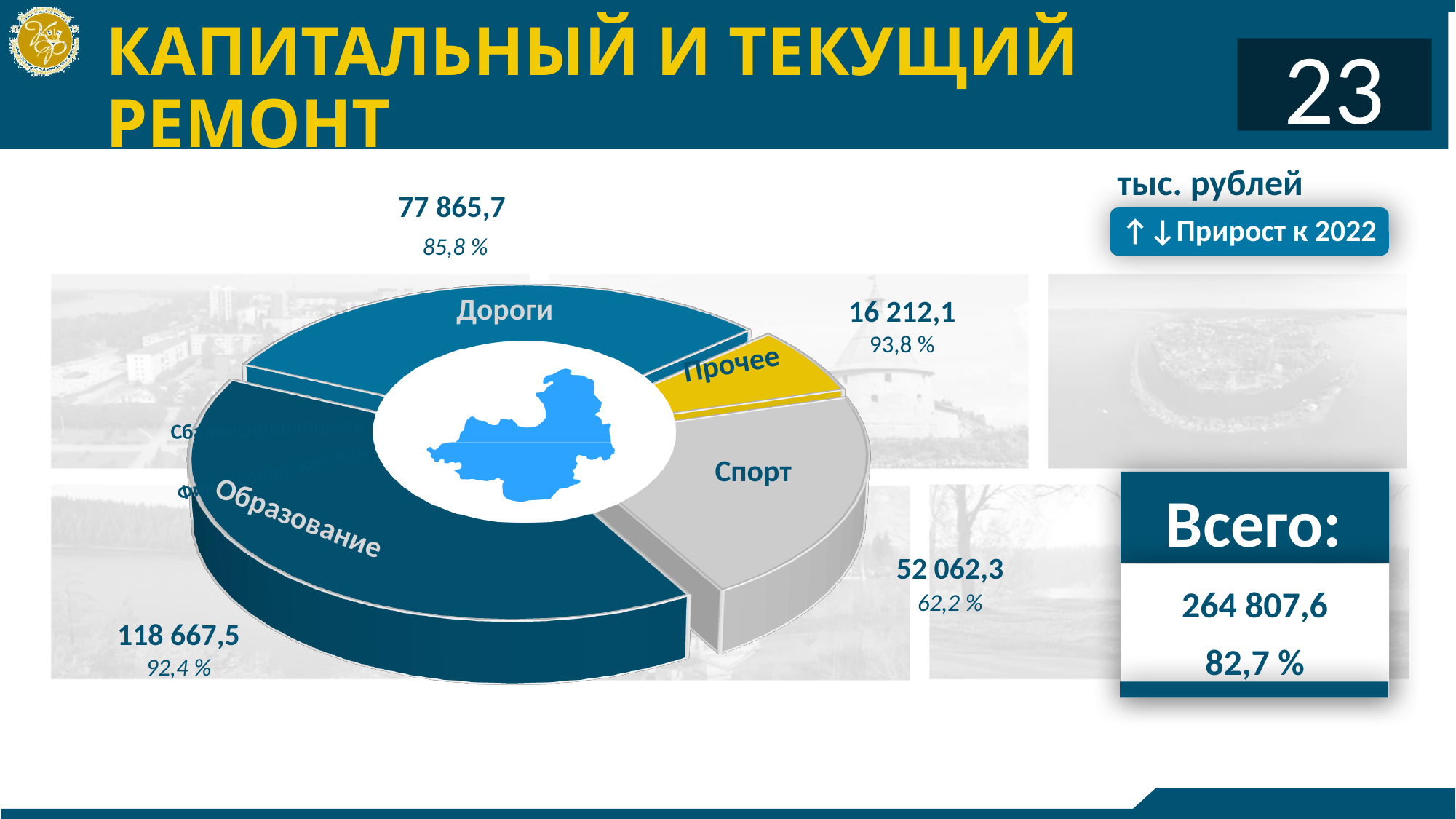
What is the total (Всего) shown for all categories? 264 807,6 What growth relative to 2022 (Прирост к 2022) is shown for Спорт? 62,2 % Which category has the highest value? Образование How many categories (segments) does the pie chart have? 4 What is the value for Дороги? 77 865,7 What is the value for Спорт? 52 062,3 What is the value for Образование? 118 667,5 Which is larger, the value for Дороги or the value for Спорт? Дороги Which category has the lowest value? Прочее What is the value for Прочее? 16 212,1 What type of chart is shown on the slide? Pie chart What is the difference between the values for Образование and Дороги? 40 801,8